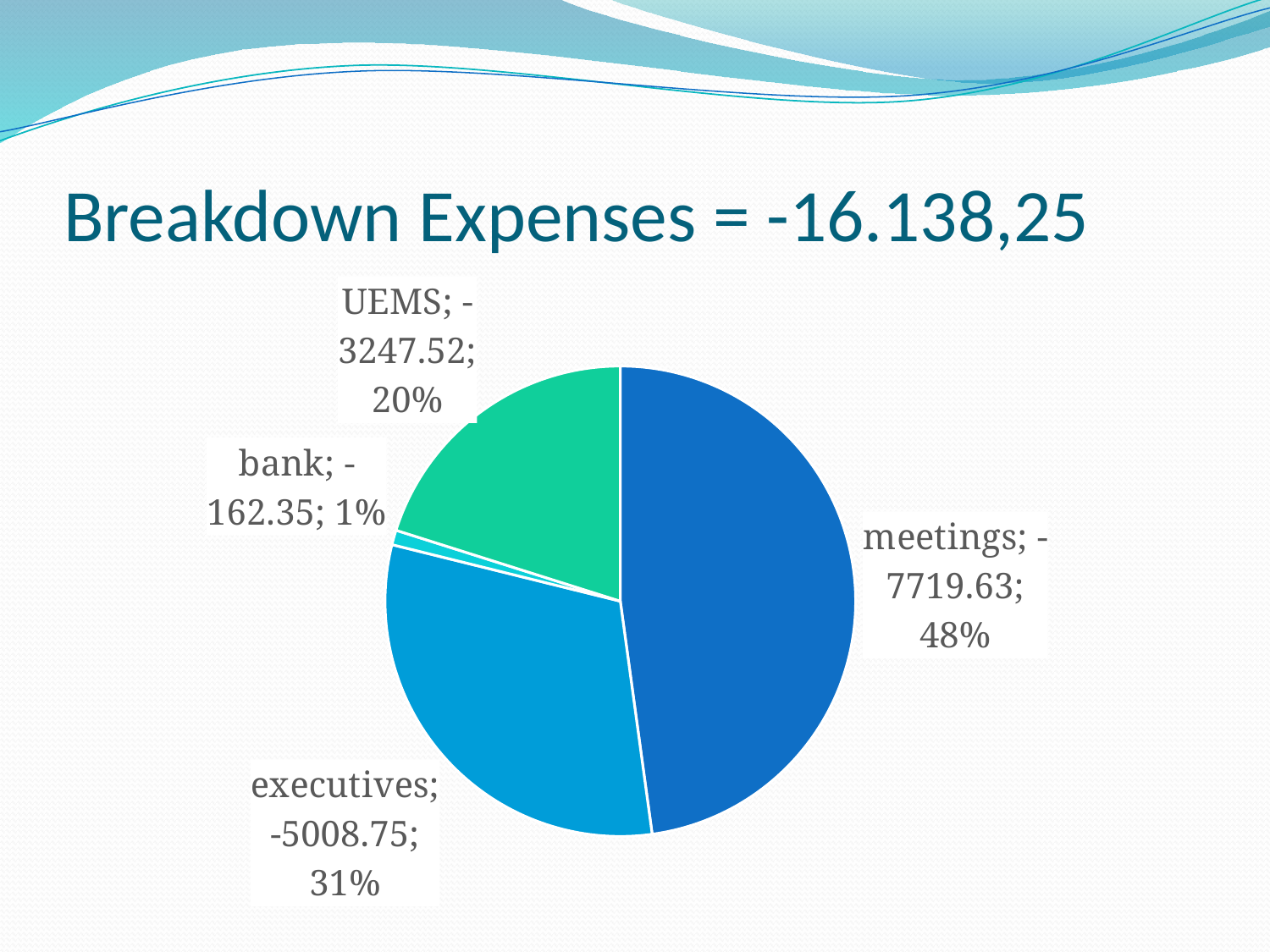
What is the title of the slide containing the chart? Breakdown Expenses = -16.138,25 What is the value shown for bank? -162.35 Which category has the largest slice of the pie? meetings What share of the pie does executives represent? 31% What is the value shown for UEMS? -3247.52 What kind of chart is shown on the slide? pie chart What is the value shown for meetings? -7719.63 Which slice is larger, UEMS or executives? executives What is the value shown for executives? -5008.75 What share of the pie does meetings represent? 48% Which category has the smallest slice of the pie? bank How many slices does the pie chart have? 4